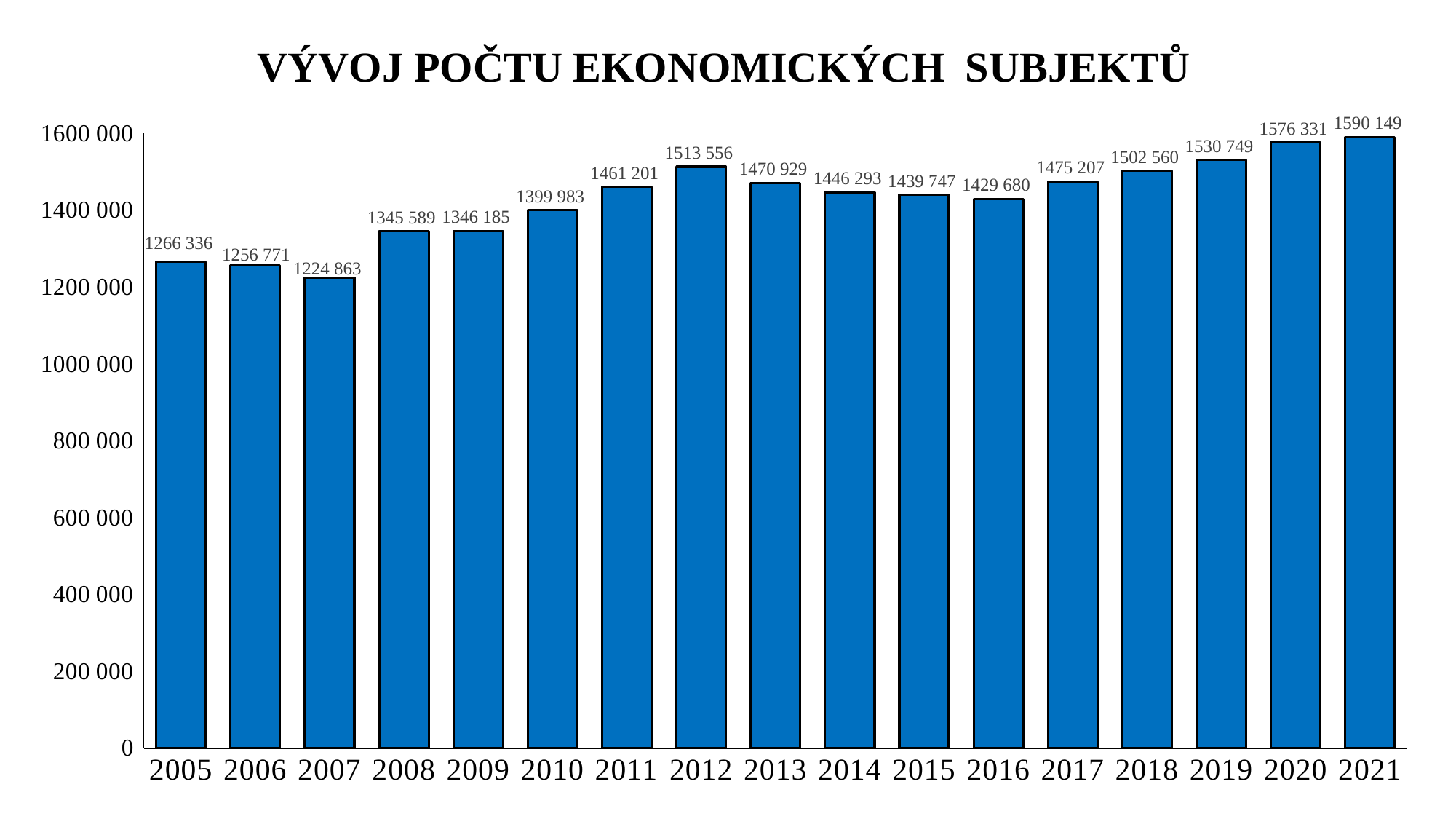
What kind of chart is shown on the slide? bar chart What is the value for 2021? 1590 149 What is the difference between the values for 2012 and 2011? 52 355 What is the value for 2012? 1513 556 Which is larger, the value for 2012 or the value for 2013? 2012 Which year has the lowest value? 2007 Between 2012 and 2016, do the values rise or fall? fall What is the value for 2007? 1224 863 Which year has the highest value? 2021 What is the difference between the values for 2021 and 2005? 323 813 How many years are shown on the x axis? 17 Is the value for 2007 greater or less than 1400 000? less